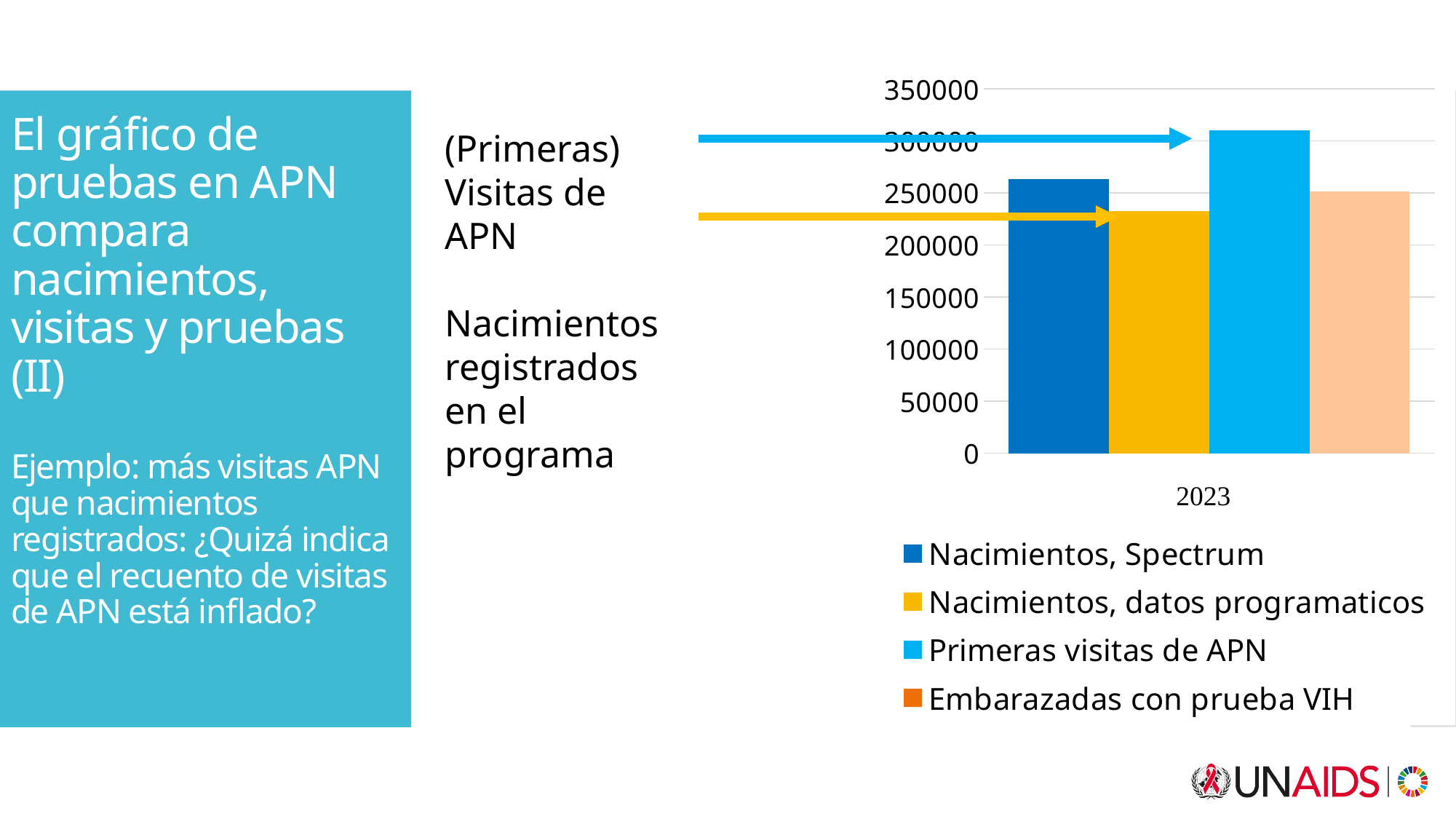
How many series does the chart legend list? 4 How many categories are shown on the x axis of the chart? 1 Which is larger, Nacimientos, Spectrum or Nacimientos, datos programaticos? Nacimientos, Spectrum Which is larger, Primeras visitas de APN or Embarazadas con prueba VIH? Primeras visitas de APN What year is shown as the category label on the x axis of the chart? 2023 Which series has the lowest bar in the chart? Nacimientos, datos programaticos Is the value for Nacimientos, datos programaticos greater or less than 250000? less Is the value for Embarazadas con prueba VIH greater or less than 200000? greater Is the value for Nacimientos, Spectrum greater or less than 250000? greater What kind of chart is shown on the slide? bar chart Which series has the highest bar in the chart? Primeras visitas de APN